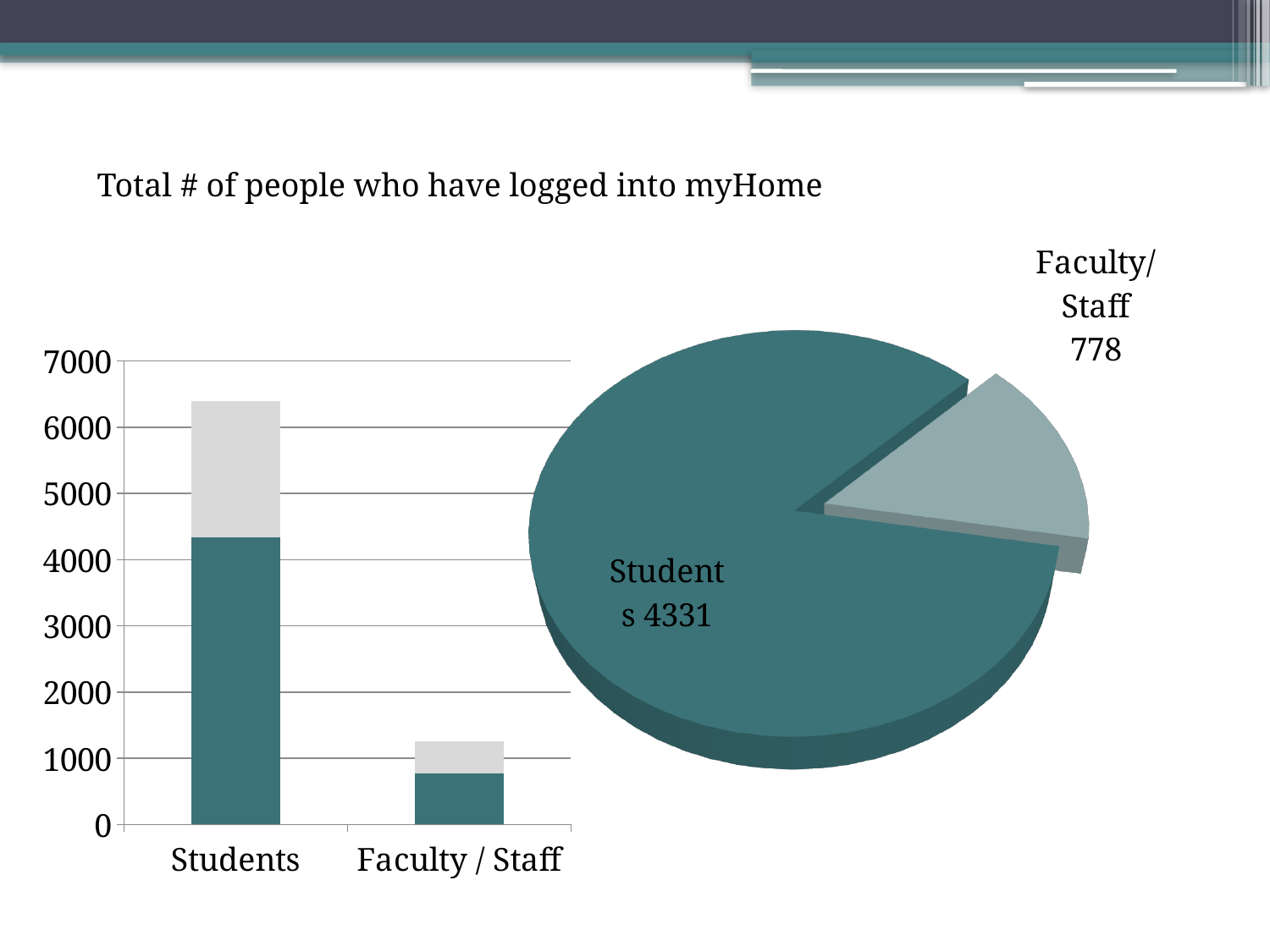
What is the title text shown above the charts on the slide? Total # of people who have logged into myHome In the bar chart on the left, which category has the tallest bar? Students In the bar chart on the left, is the total height of the Students bar greater or less than 6000? greater How many slices does the pie chart on the right have? 2 In the pie chart, what is the difference between the Students value and the Faculty/Staff value? 3553 In the pie chart, what is the value for Faculty/Staff? 778 What kind of chart is the chart on the left of the slide? bar chart In the bar chart on the left, is the total height of the Faculty / Staff bar greater or less than 2000? less In the pie chart, what is the value for Students? 4331 How many categories are shown on the x axis of the bar chart on the left? 2 What kind of chart is the chart on the right of the slide? pie chart In the pie chart, which slice is larger, Students or Faculty/Staff? Students